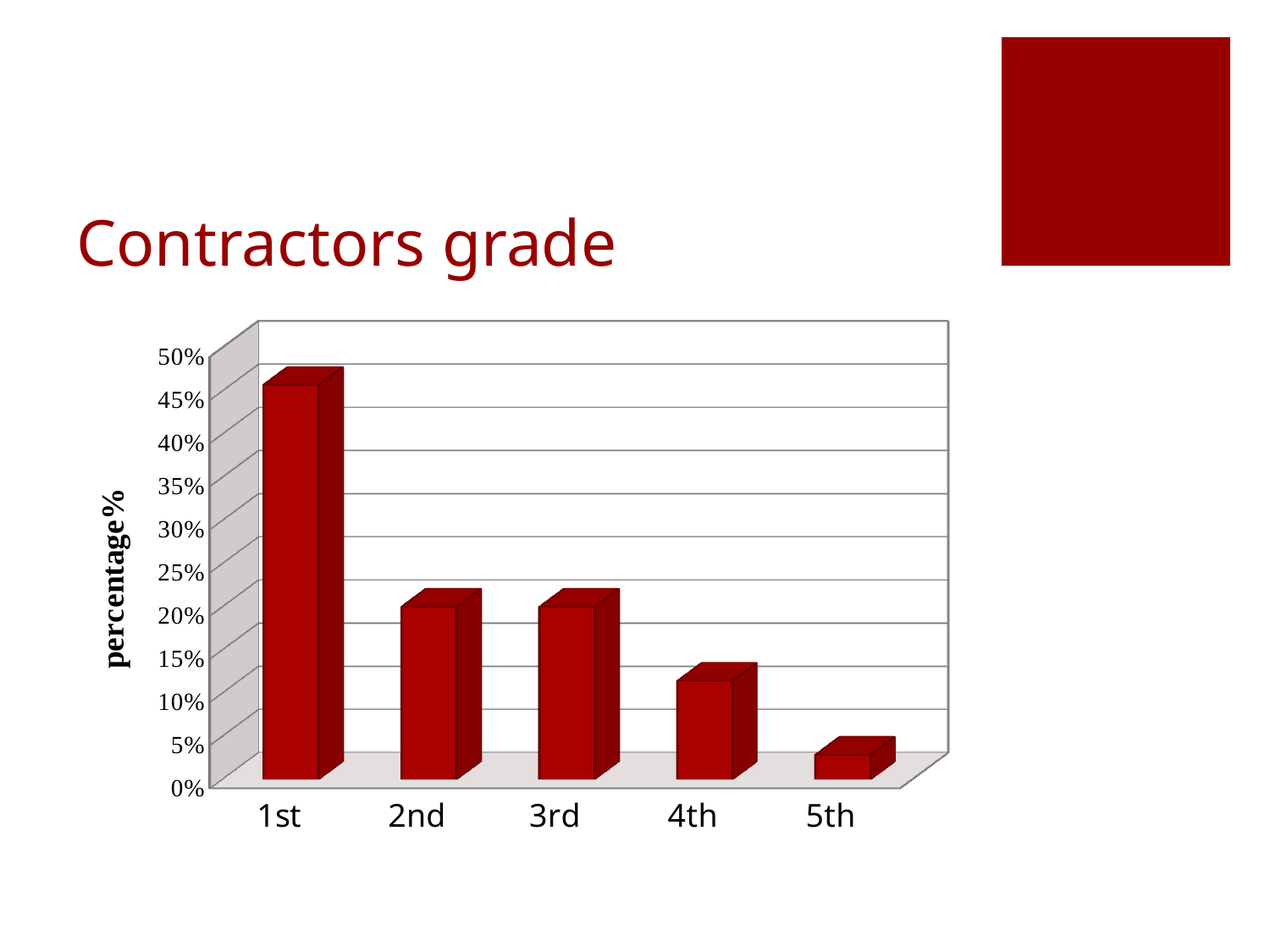
Which grade has the highest percentage? 1st How many grade categories are shown on the x axis? 5 Is the value for 3rd greater or less than 25%? less Is the value for 4th greater or less than 15%? less Which grade has the lowest percentage? 5th Is the value for 2nd greater or less than 15%? greater What kind of chart is shown on the slide? bar chart Do the values generally rise or fall from 1st to 5th along the x axis? fall What is the label on the vertical axis? percentage% Which is larger, the value for 1st or the value for 2nd? 1st